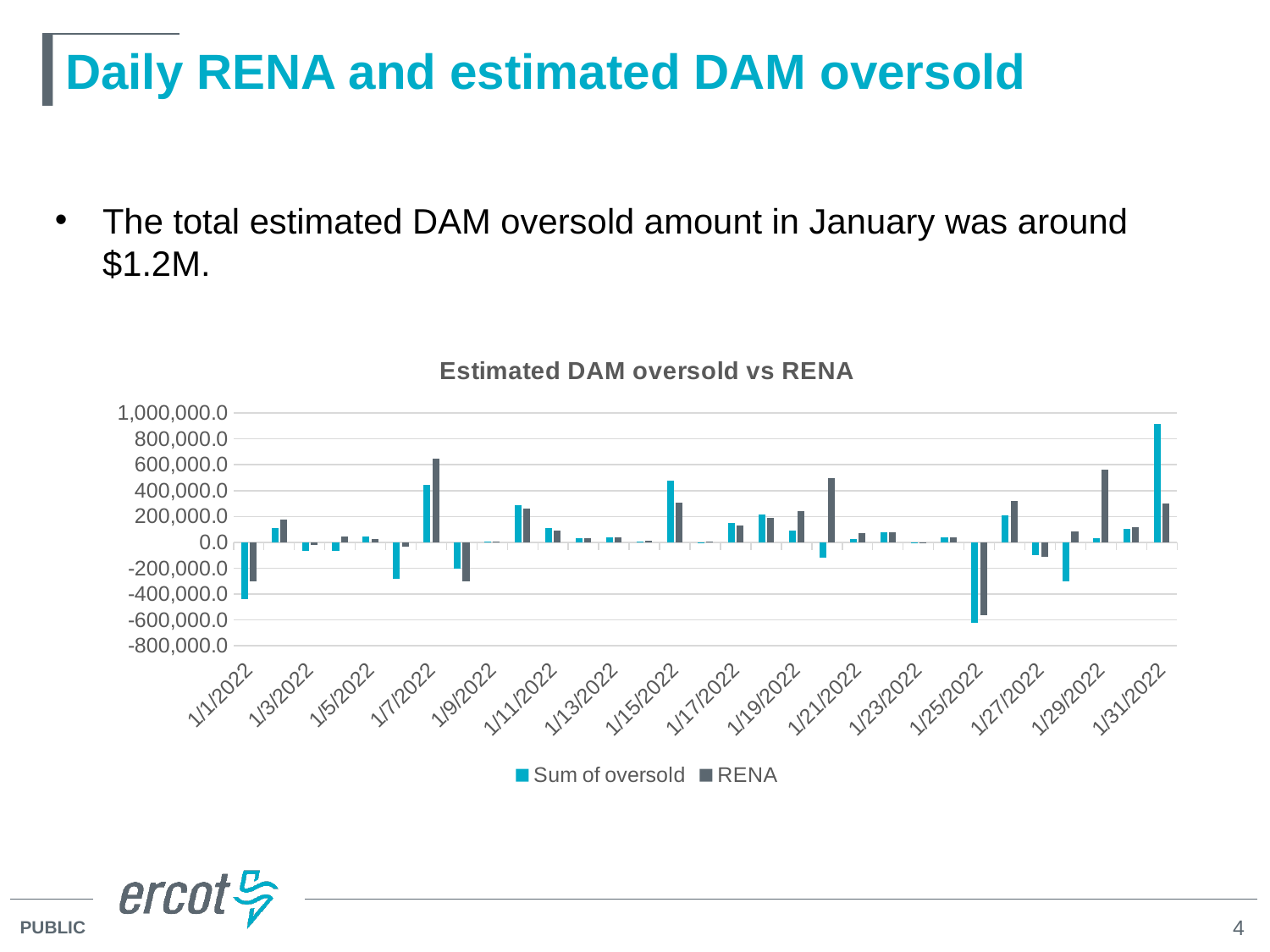
How many series does the chart legend list? 2 On 1/7/2022, which is larger: the Sum of oversold value or the RENA value? RENA On 1/31/2022, which is larger: the Sum of oversold value or the RENA value? Sum of oversold Which two series are listed in the chart legend? Sum of oversold and RENA What is the title of the chart? Estimated DAM oversold vs RENA On which date is the Sum of oversold value lowest? 1/25/2022 Is the RENA value for 1/21/2022 greater or less than 400,000.0? less Is the Sum of oversold value for 1/25/2022 greater or less than -400,000.0? less On which date is the RENA value lowest? 1/25/2022 On which date is the Sum of oversold value highest? 1/31/2022 What kind of chart is shown on the slide? Bar chart Is the Sum of oversold value for 1/31/2022 greater or less than 800,000.0? greater